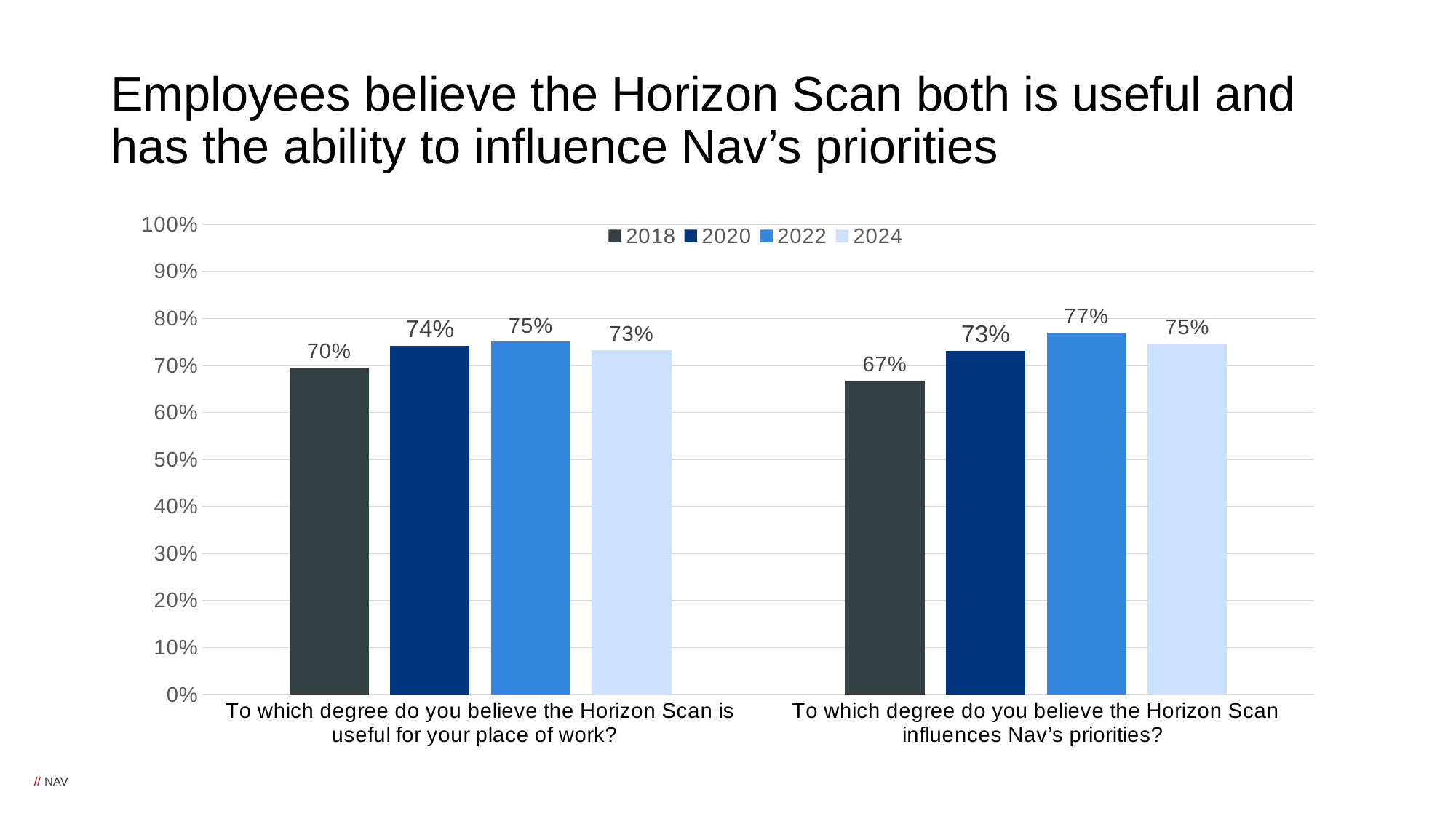
What is the difference between the 2022 and 2018 values for "To which degree do you believe the Horizon Scan influences Nav's priorities?"? 10% Which year has the lowest value for "To which degree do you believe the Horizon Scan is useful for your place of work?"? 2018 Which year is shown in the lightest blue colour in the legend? 2024 Which is larger: the 2018 value for the "useful for your place of work" question or the 2018 value for the "influences Nav's priorities" question? useful for your place of work What is the 2024 value for "To which degree do you believe the Horizon Scan is useful for your place of work?"? 73% What is the 2018 value for "To which degree do you believe the Horizon Scan is useful for your place of work?"? 70% Is the 2018 value for "To which degree do you believe the Horizon Scan influences Nav's priorities?" greater or less than 70%? less How many series does the legend list? 4 What is the 2020 value for "To which degree do you believe the Horizon Scan influences Nav's priorities?"? 73% What kind of chart is shown on the slide? Bar chart What is the 2022 value for "To which degree do you believe the Horizon Scan influences Nav's priorities?"? 77% Which year has the highest value for "To which degree do you believe the Horizon Scan influences Nav's priorities?"? 2022